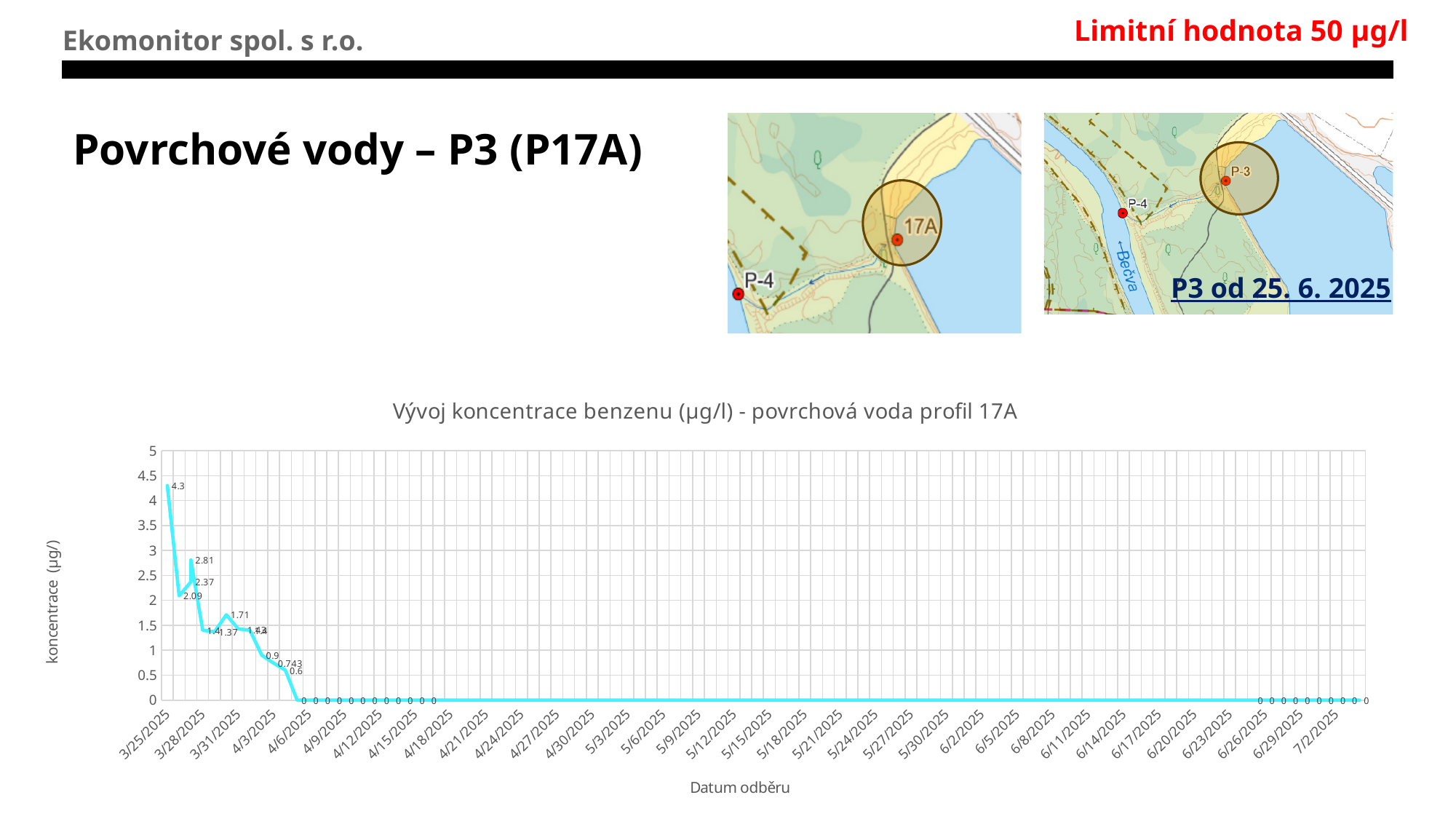
Is the value on 3/25/2025 greater or less than 4? greater What is the value plotted on 7/2/2025? 0 What is the label of the x axis? Datum odběru Which is larger, the value on 3/25/2025 or the value on 4/6/2025? 3/25/2025 What is the difference between the highest value (4.3) and the second highest value (2.81)? 1.49 What is the highest value plotted on the chart? 4.3 What is the title of the chart? Vývoj koncentrace benzenu (µg/l) - povrchová voda profil 17A What is the benzene concentration on 3/25/2025, the first point of the chart? 4.3 What kind of chart is shown on the slide? line chart What is the second highest labelled value on the chart? 2.81 Do the values rise or fall along the x axis from 3/25/2025 onward? fall